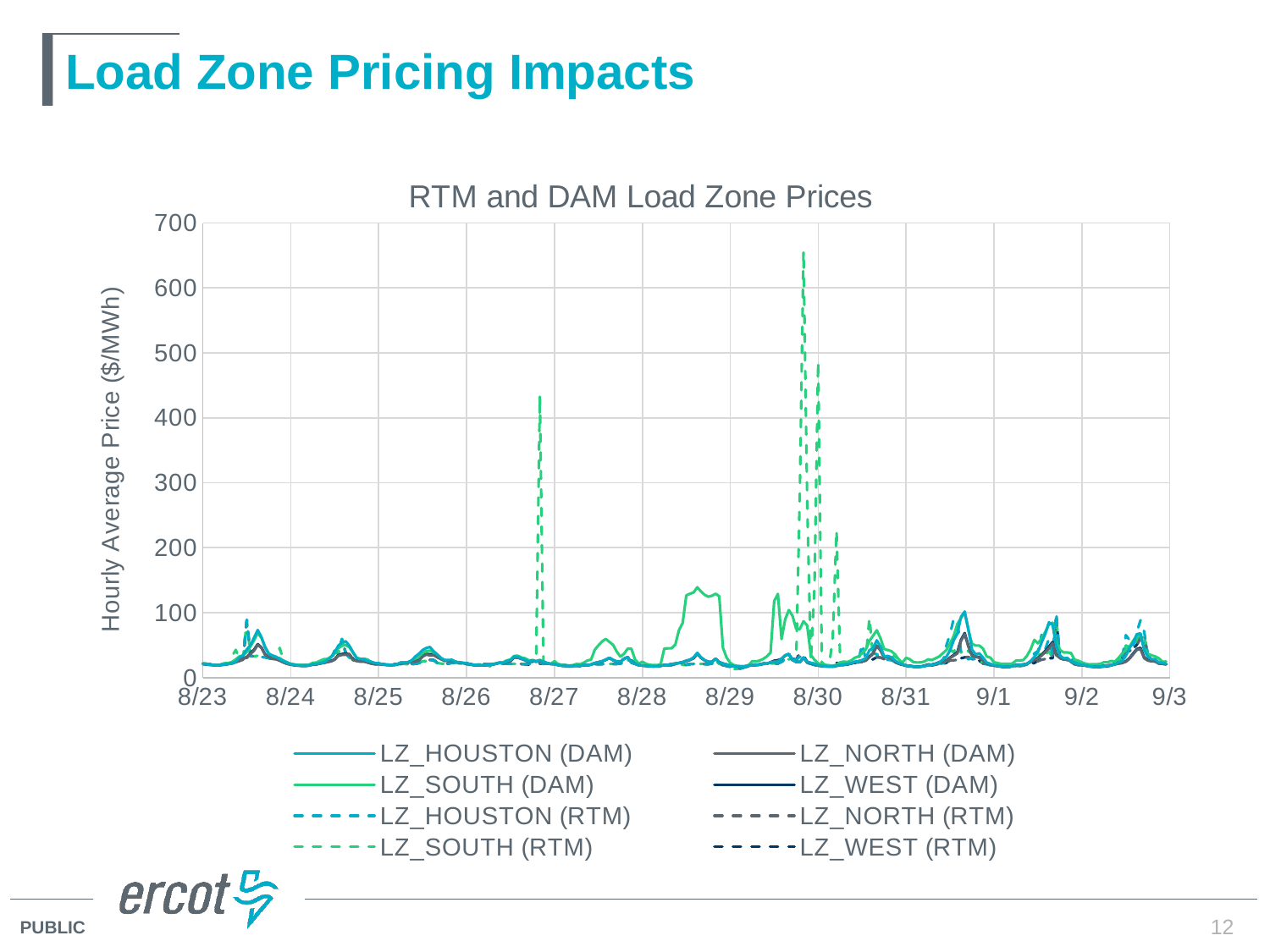
What is the title of the chart? RTM and DAM Load Zone Prices What is the label of the vertical axis? Hourly Average Price ($/MWh) What kind of chart is shown on the slide? line chart How many date labels are shown on the horizontal axis? 12 Is the peak of LZ_SOUTH (DAM) between 8/28 and 8/29 greater or less than 100? greater How many series does the legend list? 8 Is the LZ_SOUTH (RTM) spike just before 8/27 greater or less than 500? less Is the peak of LZ_SOUTH (DAM) between 8/28 and 8/29 greater or less than 200? less Which series reaches the highest value on the chart? LZ_SOUTH (RTM) Which is larger: the highest peak of LZ_SOUTH (RTM) or the highest peak of LZ_SOUTH (DAM)? LZ_SOUTH (RTM)